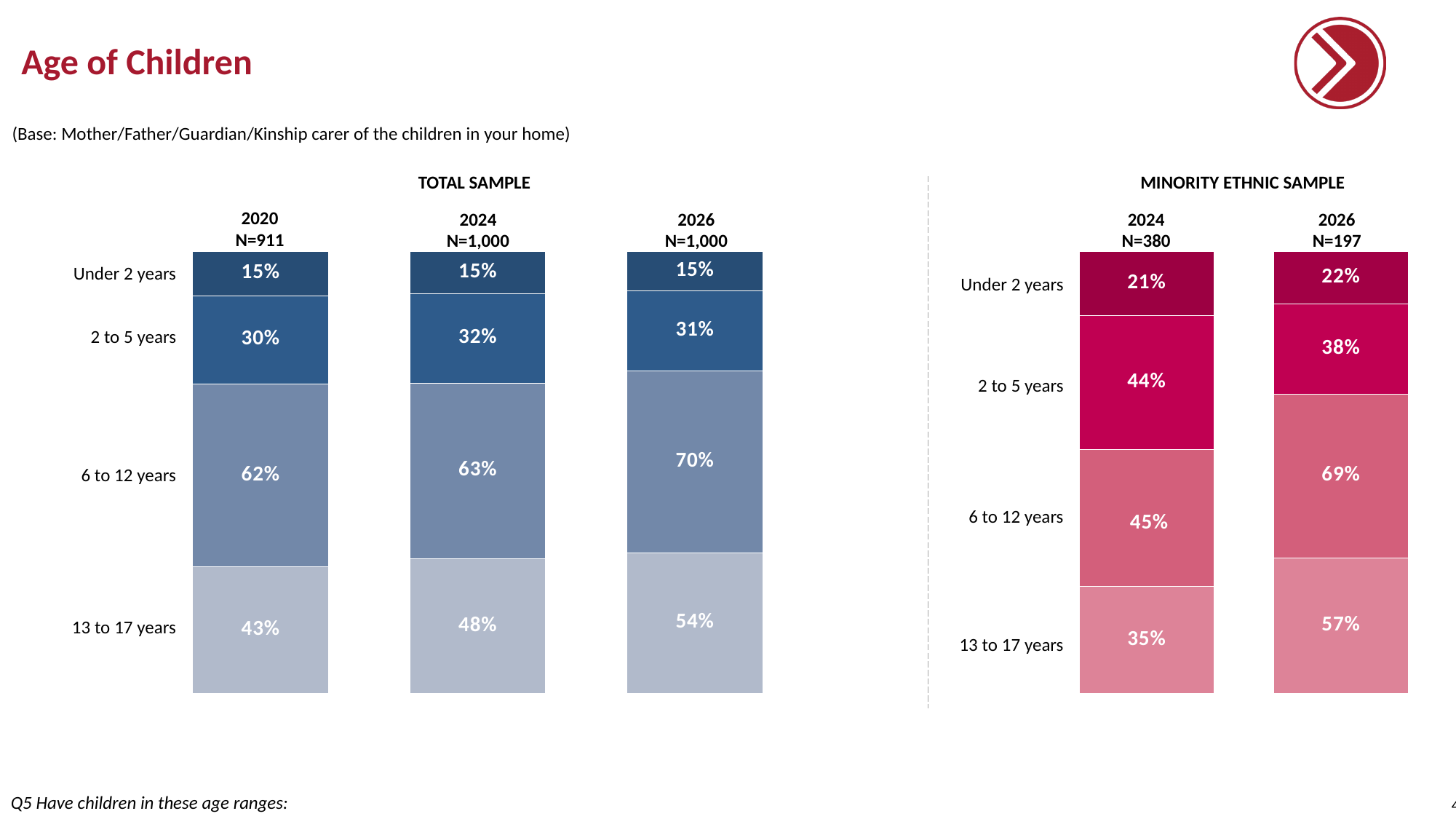
In the Minority Ethnic Sample chart, which age range has the lowest percentage in 2024? Under 2 years In the Minority Ethnic Sample chart, what percentage of the 2026 sample have children under 2 years? 22% In the Total Sample chart, what percentage of the 2026 sample have children aged 6 to 12 years? 70% In the Total Sample chart, what is the difference between the 2026 and 2020 percentages for 13 to 17 years? 11 percentage points What is the sample size (N) for the 2024 Minority Ethnic Sample? N=380 In the Minority Ethnic Sample chart, what percentage of the 2024 sample have children aged 2 to 5 years? 44% In the Total Sample chart, does the percentage for 13 to 17 years rise or fall from 2020 to 2026? rise In the Total Sample chart, which age range has the highest percentage in 2024? 6 to 12 years In the Total Sample chart, is the 2024 percentage for 2 to 5 years larger or smaller than the 2026 percentage for 2 to 5 years? larger In the Minority Ethnic Sample chart, what is the difference between the 2026 and 2024 percentages for 6 to 12 years? 24 percentage points In the Total Sample chart, what percentage of the 2020 sample have children aged 13 to 17 years? 43% How many age ranges are shown in the Total Sample chart? 4